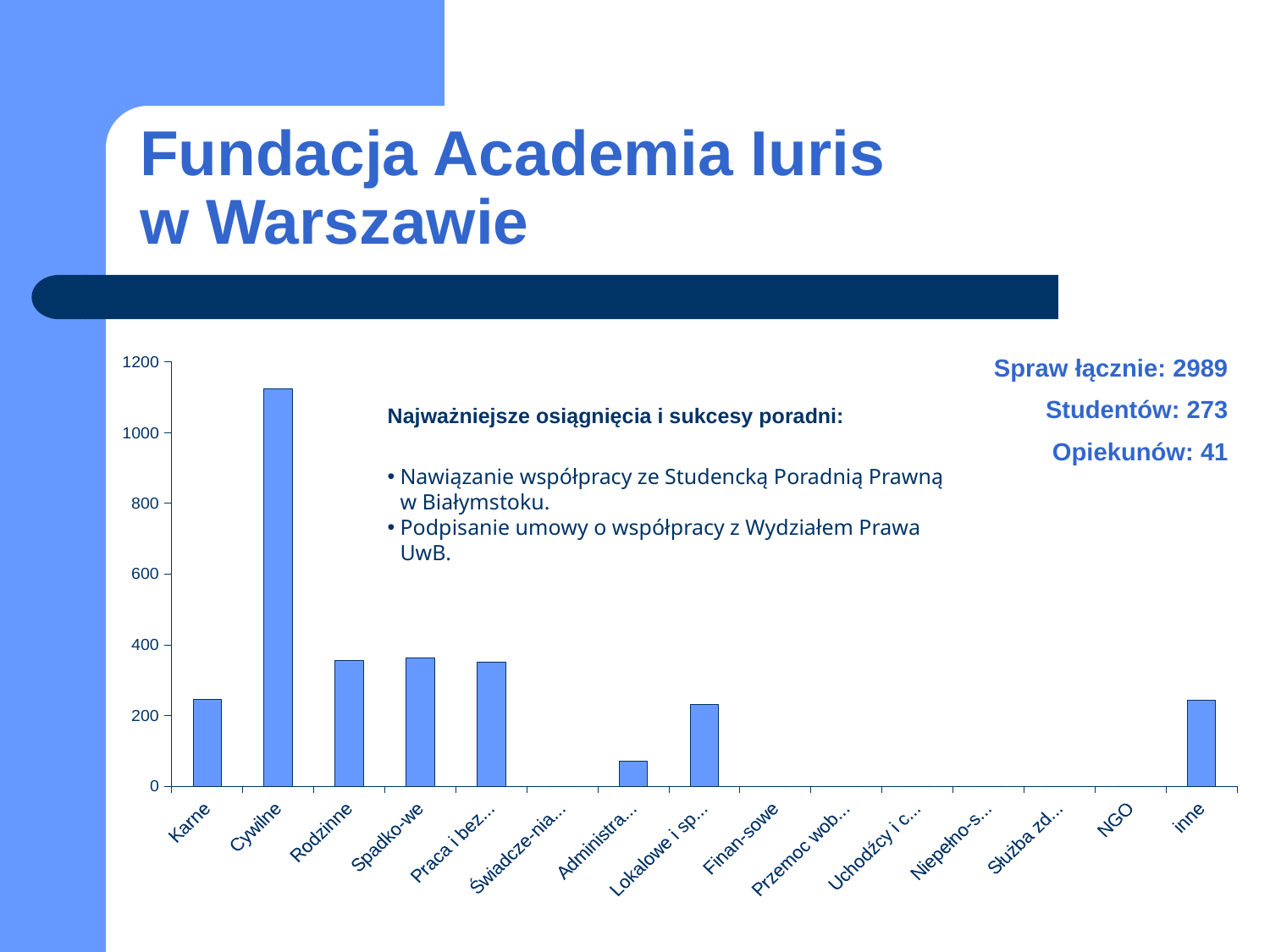
Which category has the highest bar in the chart? Cywilne Is the value for Cywilne greater or less than 1000? greater Is the value for inne greater or less than 400? less Which is larger, the value for Cywilne or the value for Karne? Cywilne Which is larger, the value for Rodzinne or the value for Administra...? Rodzinne How many categories are shown on the x axis of the chart? 15 Which is larger, the value for Lokalowe i sp... or the value for Spadko-we? Spadko-we What kind of chart is shown on the slide? bar chart Is the value for Administra... greater or less than 200? less What is the highest value shown on the y axis of the chart? 1200